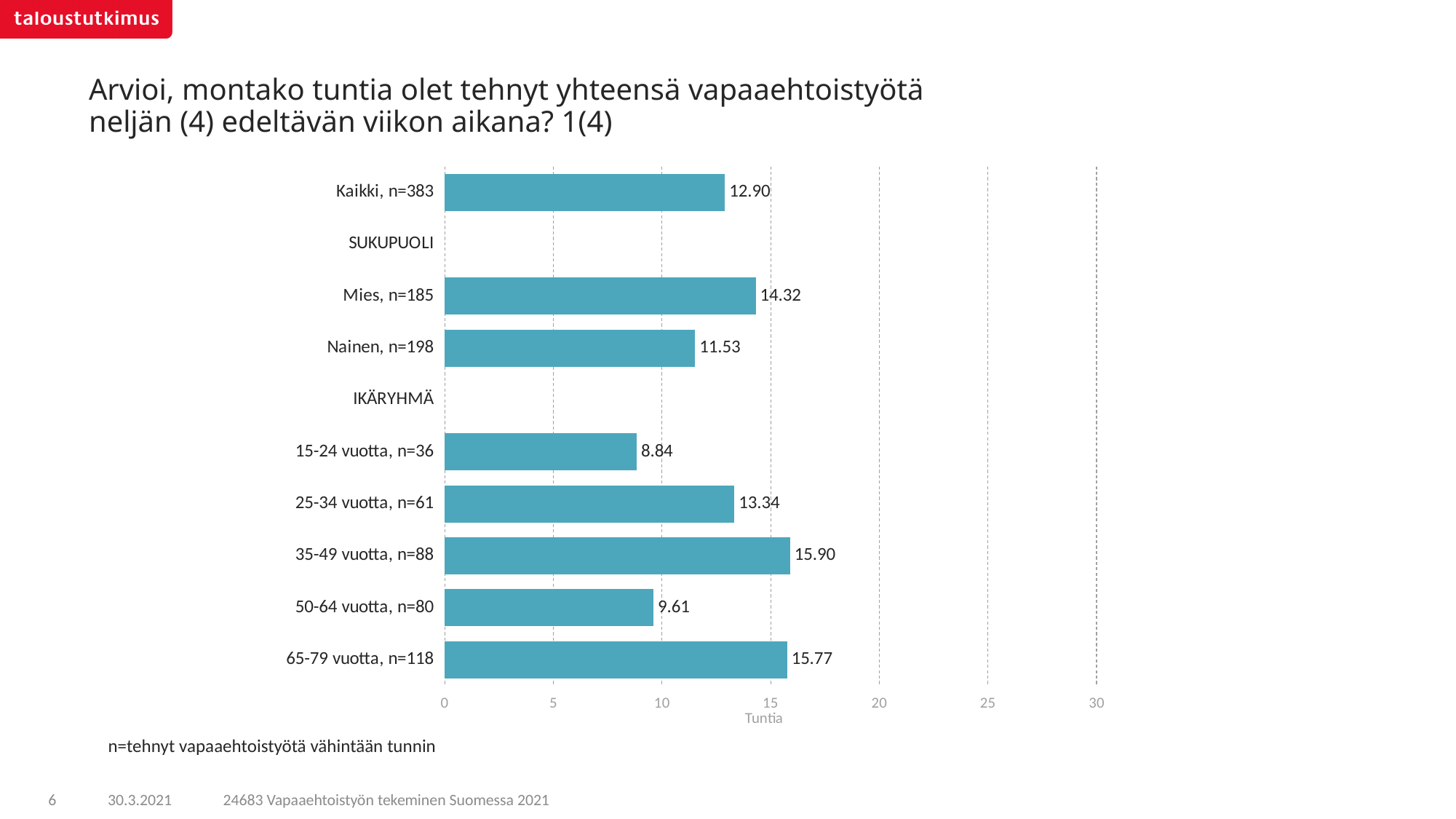
What is the difference between the values for Mies, n=185 and Nainen, n=198? 2.79 What is the value for Nainen, n=198? 11.53 Which category has the lowest value? 15-24 vuotta, n=36 What is the label of the horizontal axis? Tuntia Is the value for 35-49 vuotta, n=88 greater or less than 15? greater What is the value for Kaikki, n=383? 12.90 Which is larger, the value for 25-34 vuotta, n=61 or the value for 65-79 vuotta, n=118? 65-79 vuotta, n=118 What is the value for Mies, n=185? 14.32 What kind of chart is shown on the slide? bar chart Which category has the highest value? 35-49 vuotta, n=88 How many bars are plotted in the chart? 8 What is the value for 50-64 vuotta, n=80? 9.61